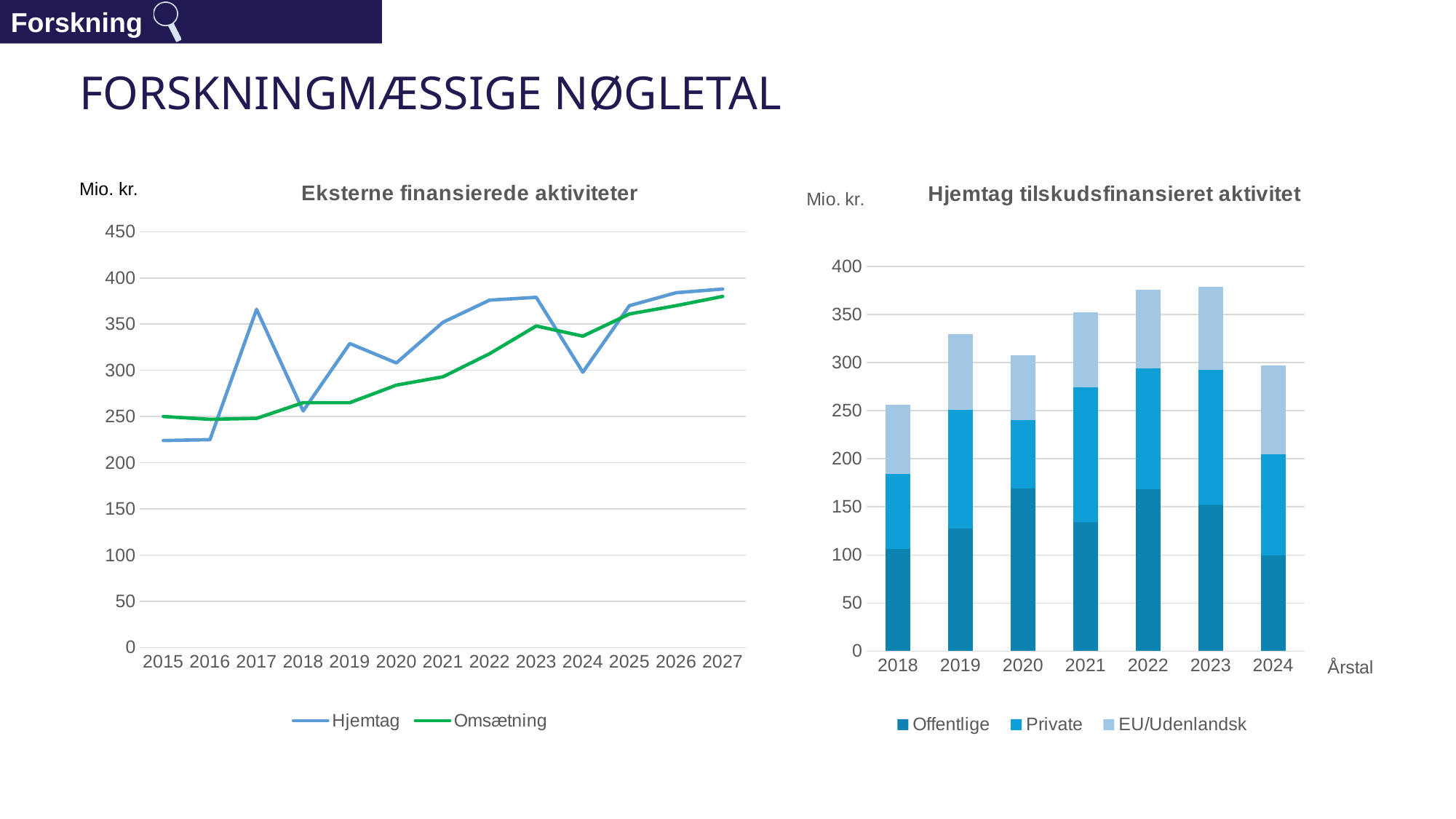
In the 'Eksterne finansierede aktiviteter' chart, is the Hjemtag value for 2015 greater or less than 250? less What kind of chart is the 'Hjemtag tilskudsfinansieret aktivitet' chart? bar chart In the 'Eksterne finansierede aktiviteter' chart, how many series does the legend list? 2 In the 'Hjemtag tilskudsfinansieret aktivitet' chart, how many years are shown on the x axis? 7 In the 'Hjemtag tilskudsfinansieret aktivitet' chart, how many series does the legend list? 3 In the 'Hjemtag tilskudsfinansieret aktivitet' chart, which year has the shortest total bar? 2018 In the 'Eksterne finansierede aktiviteter' chart, which series has the higher value in 2024, Hjemtag or Omsætning? Omsætning What kind of chart is the 'Eksterne finansierede aktiviteter' chart? line chart In the 'Eksterne finansierede aktiviteter' chart, in which year does Omsætning reach its highest value? 2027 In the 'Eksterne finansierede aktiviteter' chart, is the Hjemtag value for 2017 greater or less than 350? greater In the 'Eksterne finansierede aktiviteter' chart, how many years are shown on the x axis? 13 In the 'Hjemtag tilskudsfinansieret aktivitet' chart, is the Offentlige value for 2024 greater or less than 150? less